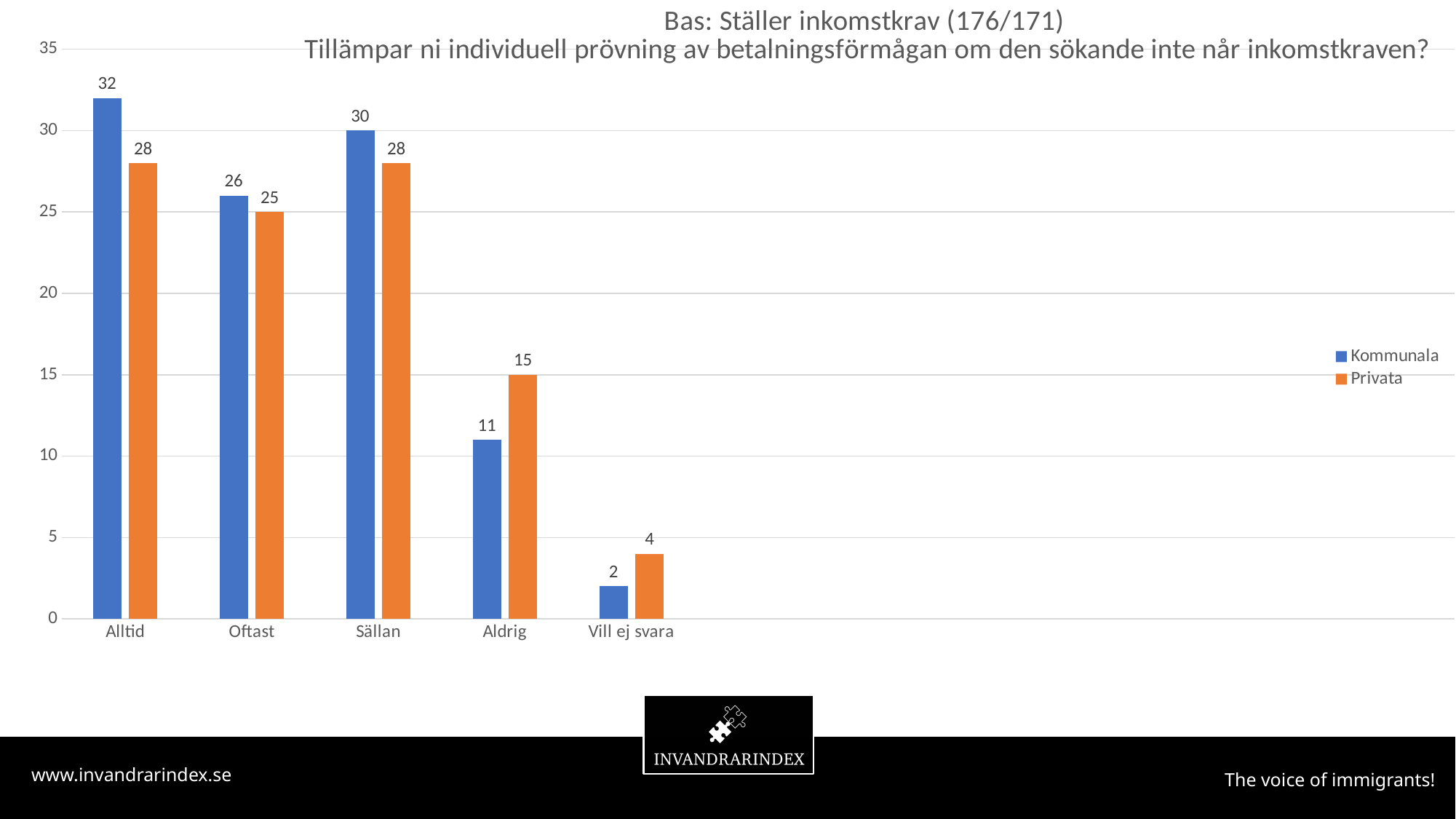
What is the difference between the Kommunala and Privata values in the Sällan category? 2 Which series is shown in orange? Privata How many series does the legend list? 2 What kind of chart is shown on the slide? Bar chart Which is larger in the Aldrig category, Kommunala or Privata? Privata What is the value for Kommunala in the Alltid category? 32 How many categories are shown on the x axis? 5 What is the difference between the Kommunala values for Alltid and Vill ej svara? 30 Which category has the highest value for Kommunala? Alltid Which category has the lowest value for Privata? Vill ej svara What is the value for Privata in the Aldrig category? 15 What is the value for Privata in the Oftast category? 25